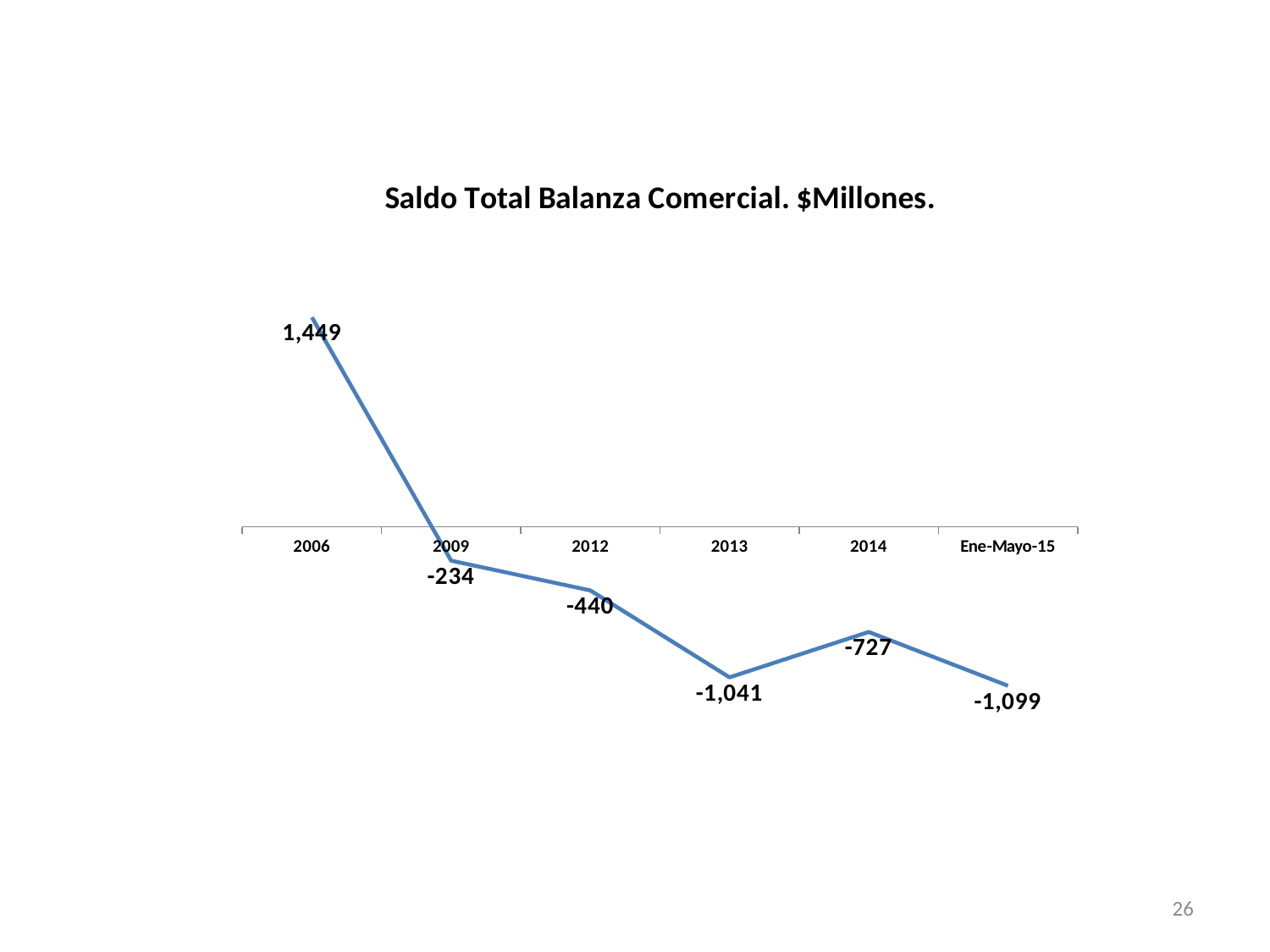
What is the value for Ene-Mayo-15? -1,099 What is the difference between the values for 2014 and 2013? 314 What is the title of the chart? Saldo Total Balanza Comercial. $Millones. What kind of chart is shown? line chart How many data points are plotted on the chart? 6 What is the value for 2006? 1,449 Which is larger, the value for 2012 or the value for 2014? 2012 Which category has the highest value? 2006 What is the difference between the values for 2006 and 2009? 1,683 Which category has the lowest value? Ene-Mayo-15 What is the value for 2013? -1,041 What is the value for 2009? -234